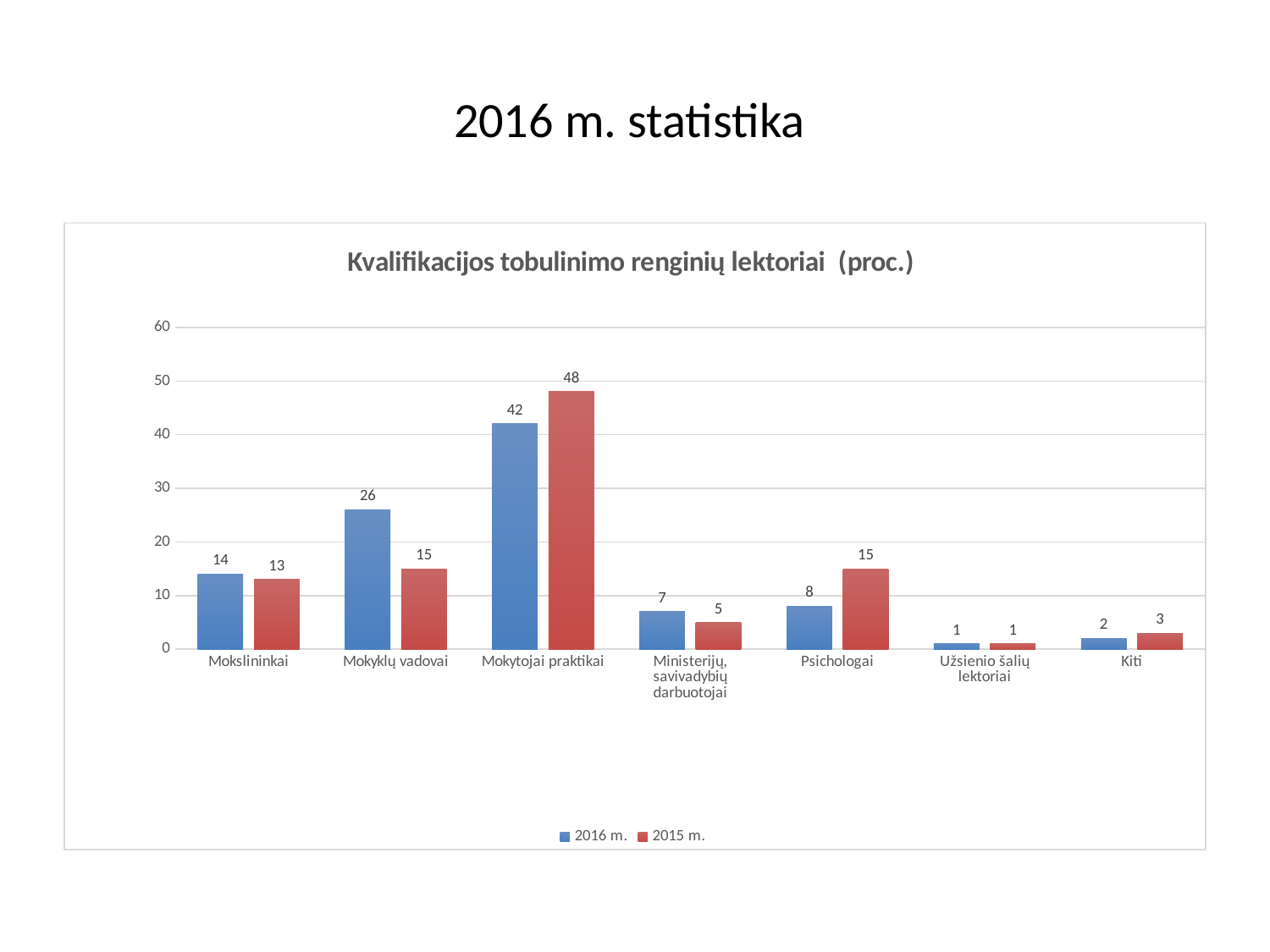
How many series does the legend list? 2 What is the value for Psichologai in the 2015 m. series? 15 Is the 2016 m. value for Mokytojai praktikai greater or less than 40? greater Which colour represents the 2015 m. series? red What is the value for Mokyklų vadovai in the 2016 m. series? 26 What is the title of the chart? Kvalifikacijos tobulinimo renginių lektoriai (proc.) Which is larger for Mokyklų vadovai: the 2016 m. value or the 2015 m. value? 2016 m. Which category has the highest value in the 2015 m. series? Mokytojai praktikai What kind of chart is shown on the slide? bar chart What is the difference between the 2015 m. and 2016 m. values for Mokytojai praktikai? 6 How many categories are shown on the x axis? 7 Which category has the lowest value in the 2016 m. series? Užsienio šalių lektoriai